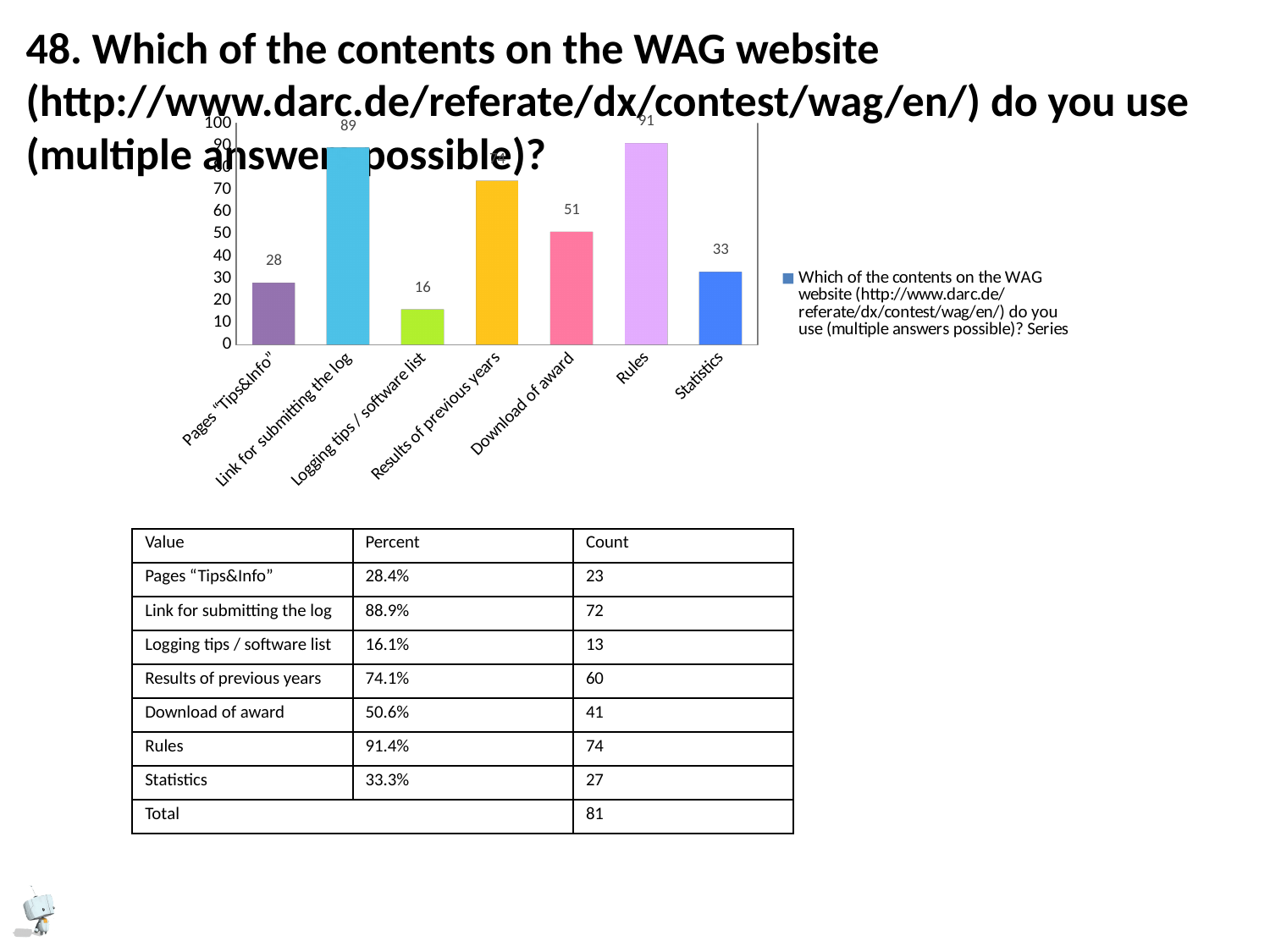
What is the value for Download of award in the chart? 51 How many series does the chart legend list? 1 Is the value for Results of previous years greater or less than 60? greater Which category has the lowest value in the chart? Logging tips / software list What kind of chart is shown on the slide? bar chart Which has a larger value, Download of award or Statistics? Download of award How many categories are shown on the x axis of the chart? 7 What is the value for Link for submitting the log in the chart? 89 What is the value for Statistics in the chart? 33 What is the value for Pages "Tips&Info" in the chart? 28 What is the difference between the values for Statistics and Pages "Tips&Info"? 5 What is the value for Logging tips / software list in the chart? 16